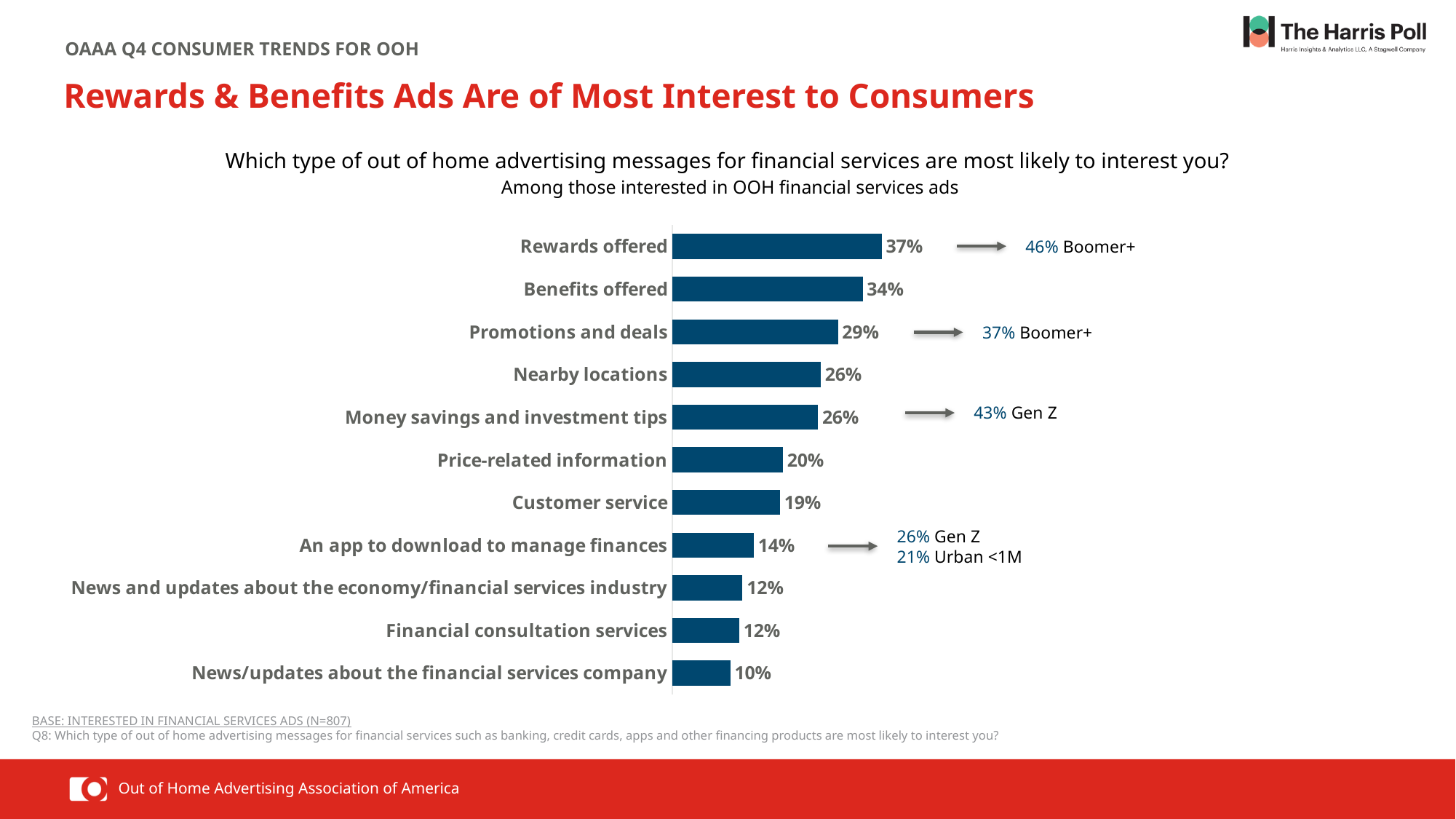
What is the value shown for 'Money savings and investment tips'? 26% How many categories are shown in the chart? 11 According to the callout next to 'Money savings and investment tips', what percentage of Gen Z respondents chose it? 43% What is the value shown for 'An app to download to manage finances'? 14% What percentage of respondents said 'Rewards offered' ads are most likely to interest them? 37% According to the callout next to 'Rewards offered', what percentage of Boomer+ respondents chose it? 46% Which category has the highest value in the chart? Rewards offered Which category has the lowest value in the chart? News/updates about the financial services company Which is larger, the value for 'Price-related information' or the value for 'Customer service'? Price-related information What is the difference between the values for 'Promotions and deals' and 'Customer service'? 10% What is the difference between the values for 'Rewards offered' and 'Benefits offered'? 3% What kind of chart is shown on the slide? Bar chart